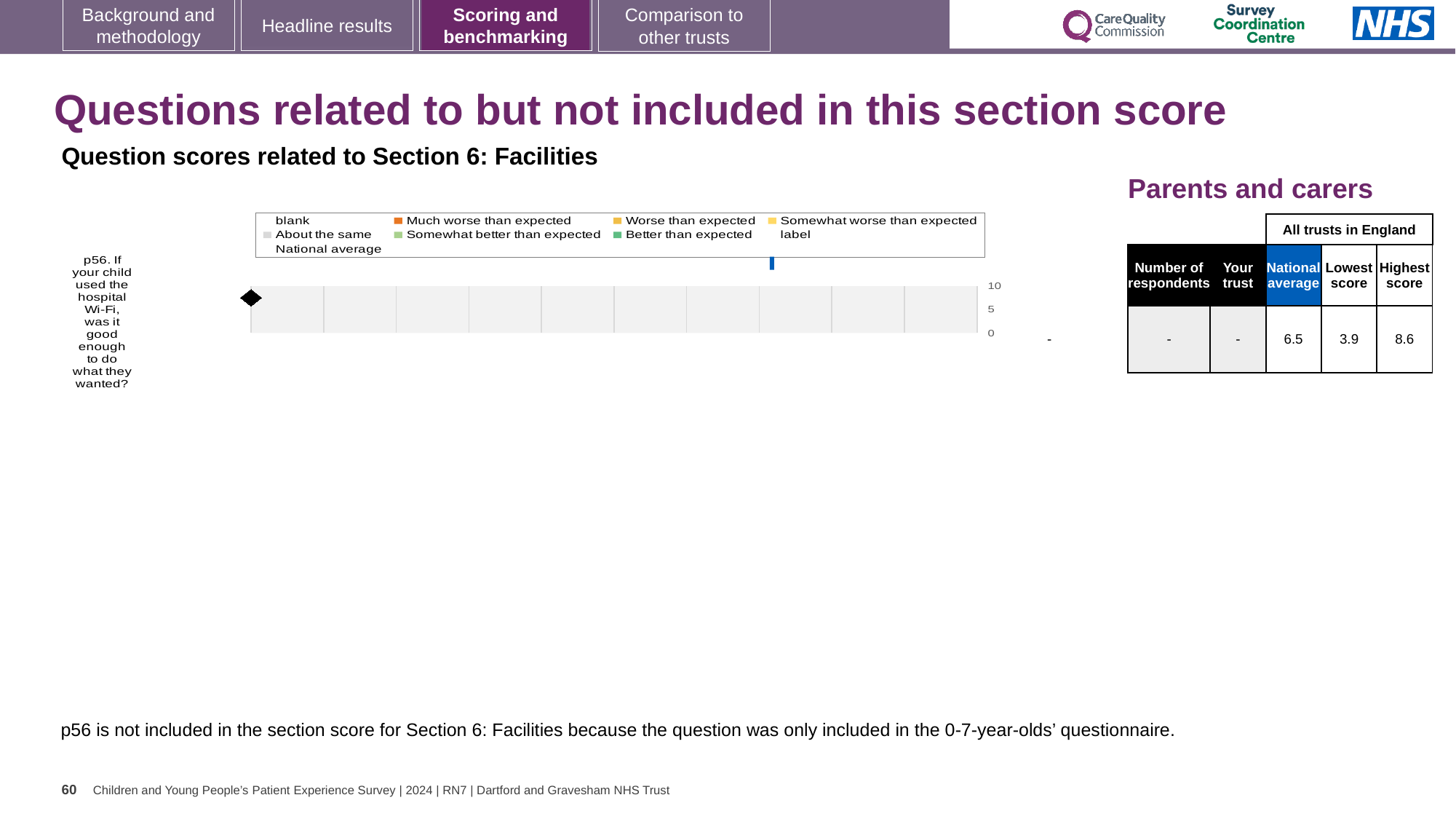
In the table next to the chart, what is the highest score across all trusts in England for p56? 8.6 How many questions (categories) are plotted on the chart? 1 In the table next to the chart, what is the lowest score across all trusts in England for p56? 3.9 What is the highest value shown on the chart's value axis? 10 Which question is plotted on the chart? p56. If your child used the hospital Wi-Fi, was it good enough to do what they wanted? In the table next to the chart, what is the difference between the highest score and the lowest score for p56? 4.7 What kind of chart is shown on the slide? bar chart In the table next to the chart, what is the national average score for p56? 6.5 How many entries does the chart legend list? 9 In the table next to the chart, what is shown for the trust's own score for p56? -